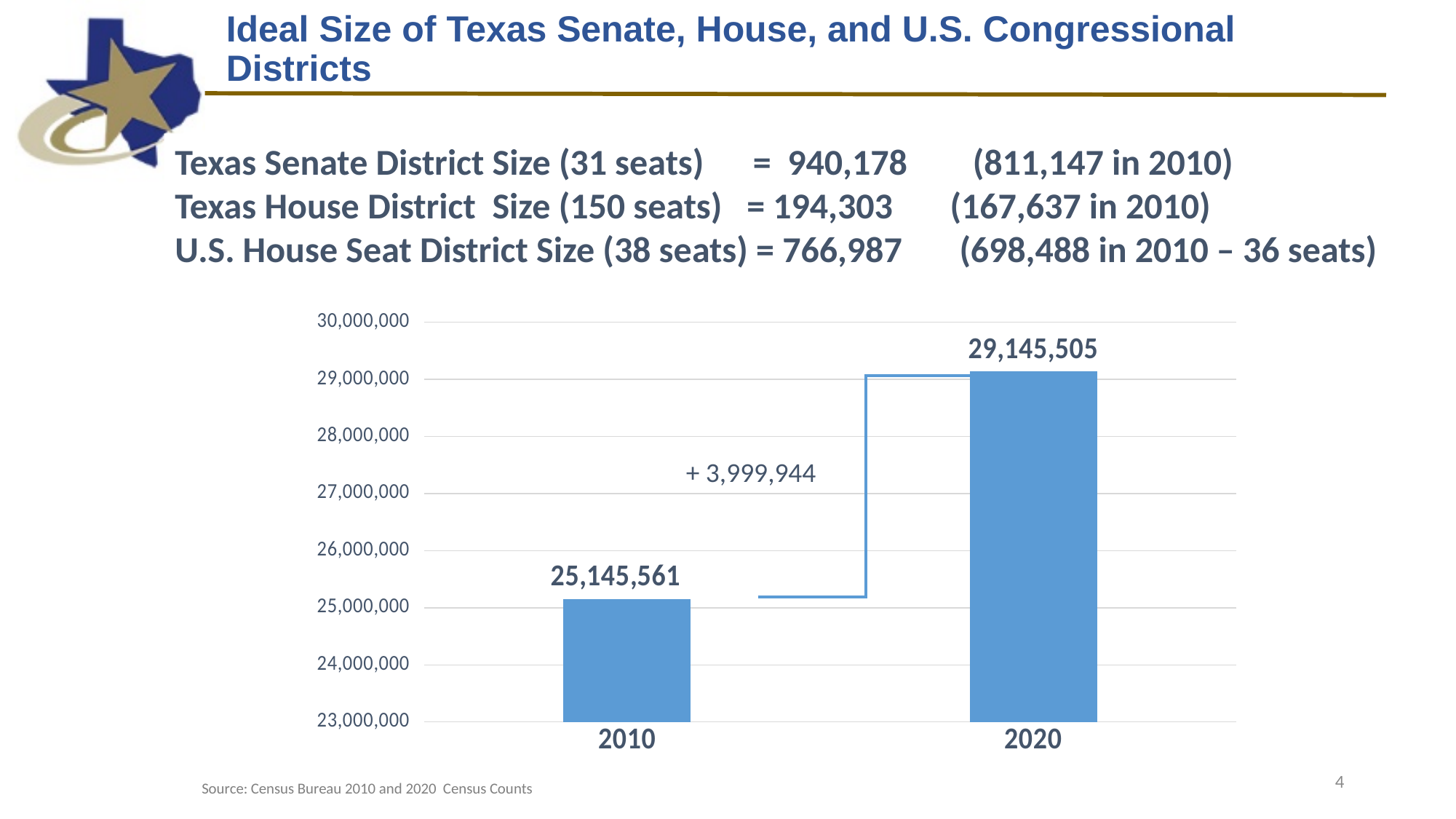
What is the difference between the 2020 and 2010 values in the bar chart? 3,999,944 What kind of chart is shown on the slide? Bar chart What is the value shown for 2020 in the bar chart? 29,145,505 Which year has the higher value in the bar chart, 2010 or 2020? 2020 What is the lowest value shown on the chart's vertical axis? 23,000,000 How many bars are plotted in the chart? 2 Which year has the lowest value in the bar chart? 2010 Is the value for 2010 greater or less than 26,000,000? less What source is cited below the chart? Census Bureau 2010 and 2020 Census Counts Do the values rise or fall from 2010 to 2020 in the chart? Rise Is the value for 2020 greater or less than 29,000,000? greater What is the value shown for 2010 in the bar chart? 25,145,561